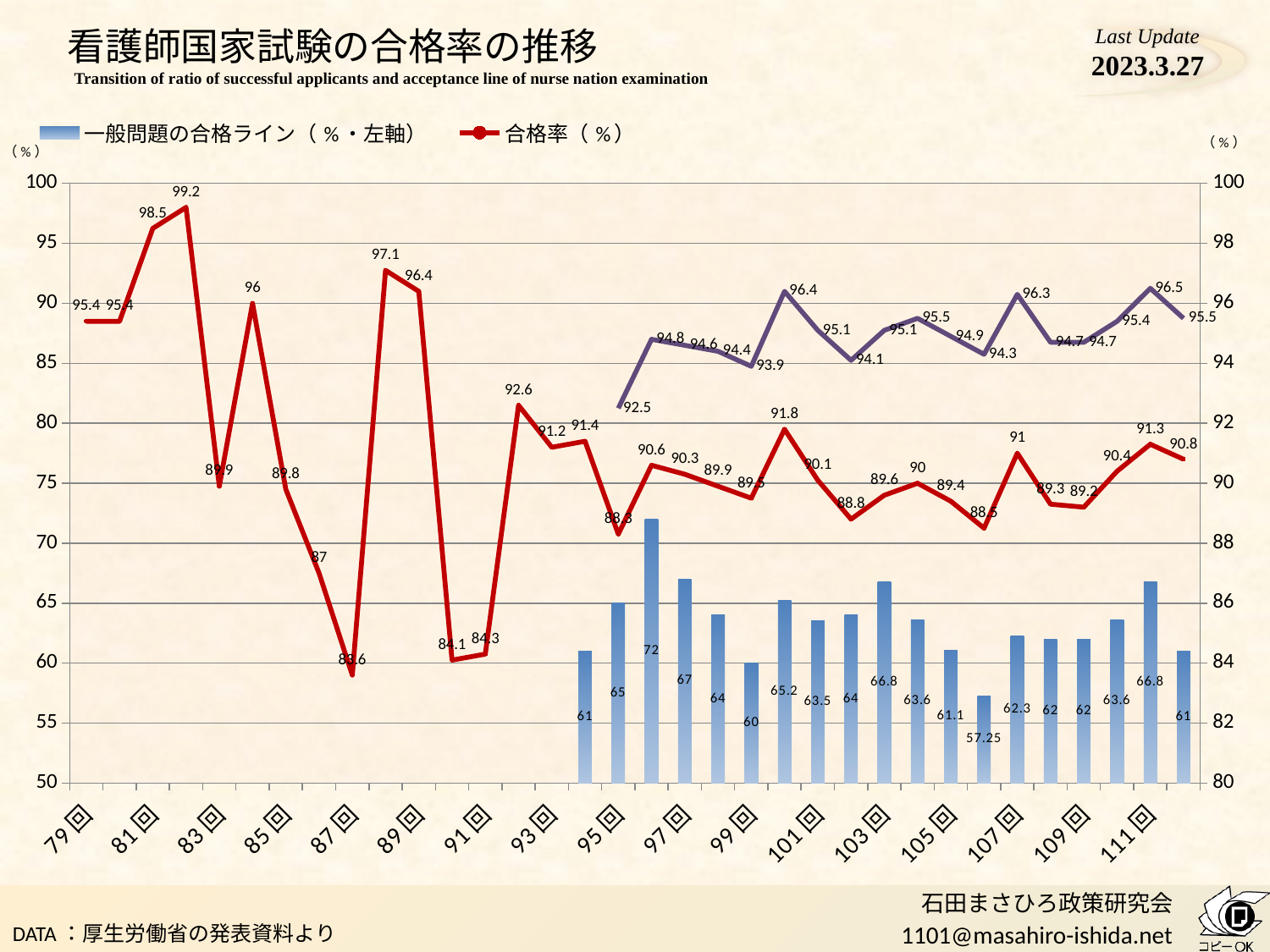
What is the 合格率 value for 107回? 91 What is the 合格率 value for 81回? 98.5 What is the lowest value shown on the 合格率 line? 83.6 What is the lowest value among the 一般問題の合格ライン bars? 57.25 Which has the larger 一般問題の合格ライン bar, 95回 or 97回? 97回 What is the value of the 一般問題の合格ライン bar for 111回? 66.8 What is the difference between the 一般問題の合格ライン bars for 111回 and 109回? 4.8 How many series does the legend list? 2 What kind of chart is shown on the slide? Combined bar and line chart What is the value of the 一般問題の合格ライン bar for 95回? 65 Does the 合格率 line rise or fall from 79回 to 81回? Rise What is the highest value shown on the 合格率 line? 99.2